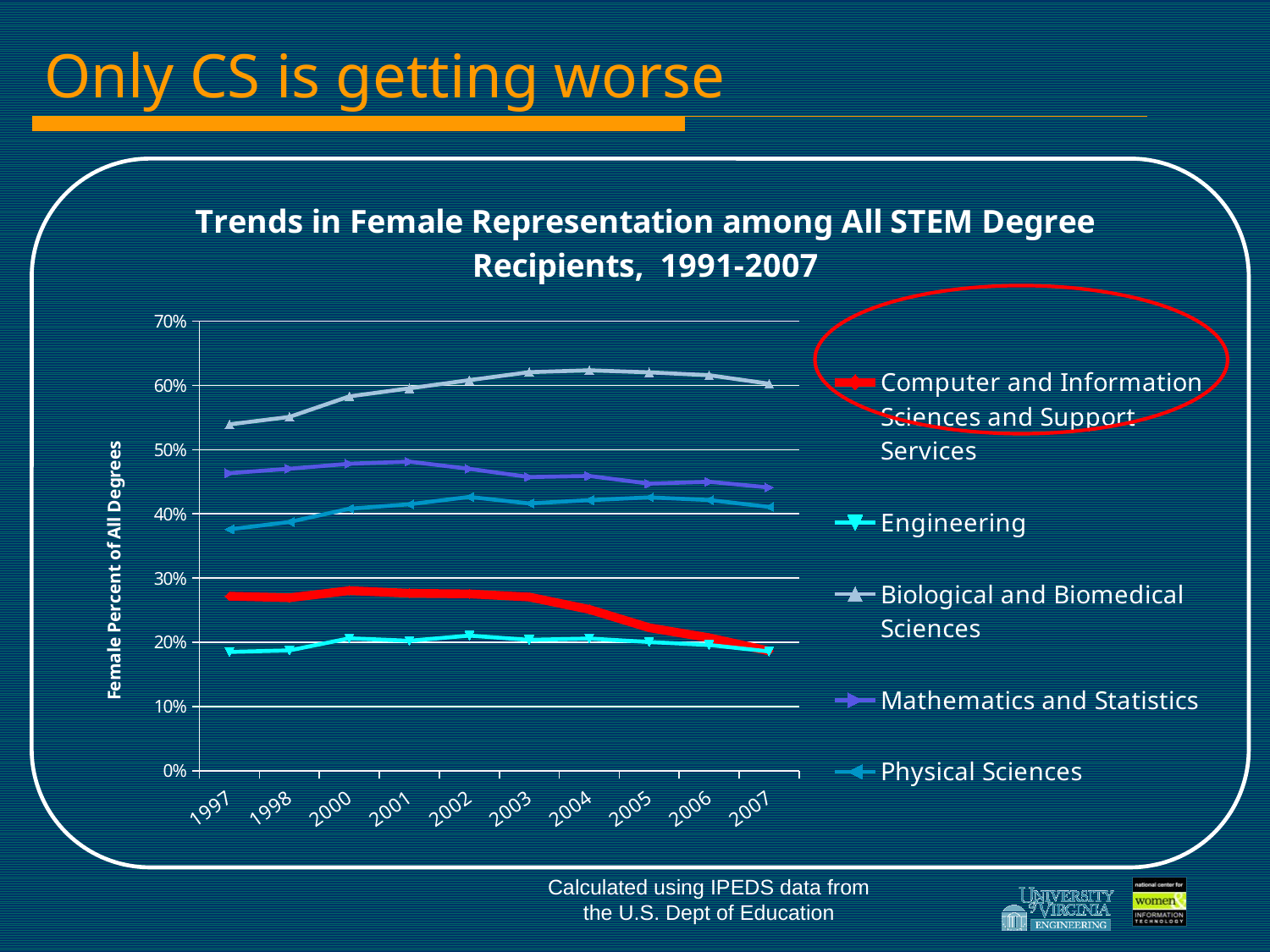
How many series does the legend list? 5 Which series has the highest values across the chart? Biological and Biomedical Sciences Does the Computer and Information Sciences and Support Services line rise or fall from 2003 to 2007? Fall Is the value for Mathematics and Statistics in 2000 greater or less than 50%? less What kind of chart is shown on the slide? Line chart Which series has the lowest values in 1997? Engineering Is the value for Computer and Information Sciences and Support Services in 1997 greater or less than 30%? less How many years are marked along the x axis? 10 Is the value for Biological and Biomedical Sciences in 2004 greater or less than 60%? greater What is the label on the y axis? Female Percent of All Degrees What is the title of the chart? Trends in Female Representation among All STEM Degree Recipients, 1991-2007 In 1997, which is larger: the value for Computer and Information Sciences and Support Services or the value for Engineering? Computer and Information Sciences and Support Services